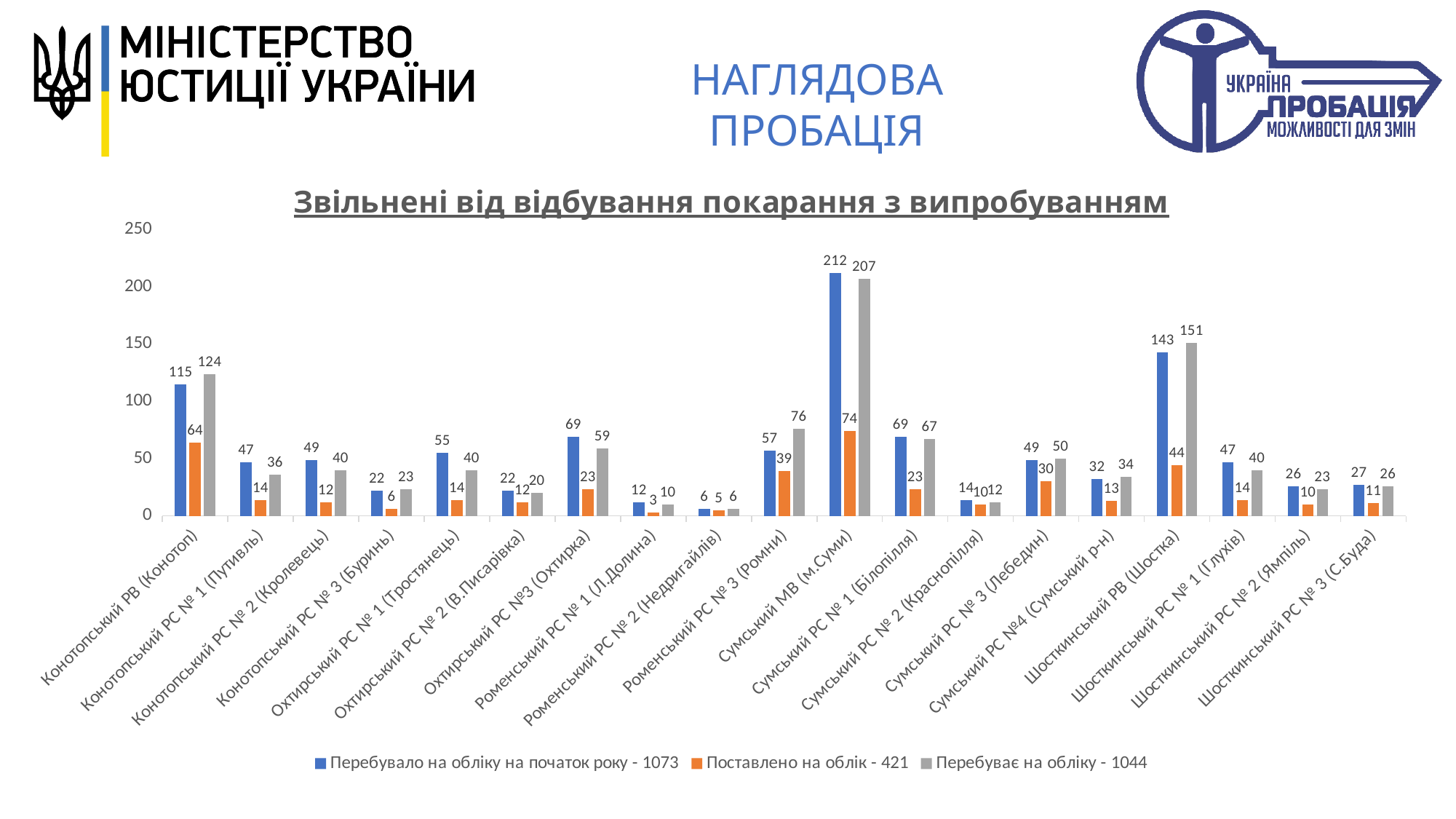
What is the difference between "Перебуває на обліку" and "Перебувало на обліку на початок року" for Шосткинський РВ (Шостка)? 8 What is the title of the chart? Звільнені від відбування покарання з випробуванням What is the value of "Перебуває на обліку" for Роменський РС № 3 (Ромни)? 76 How many series does the legend list? 3 How many categories are shown on the x axis? 19 Which category has the lowest value for "Поставлено на облік"? Роменський РС № 1 (Л.Долина) What total is shown in the legend for the series "Поставлено на облік"? 421 What is the value of "Поставлено на облік" for Конотопський РВ (Конотоп)? 64 What is the value of "Перебувало на обліку на початок року" for Сумський МВ (м.Суми)? 212 Which is larger for Охтирський РС № 1 (Тростянець): "Перебувало на обліку на початок року" or "Перебуває на обліку"? Перебувало на обліку на початок року What type of chart is shown on the slide? bar chart Which category has the highest value for "Перебуває на обліку"? Сумський МВ (м.Суми)